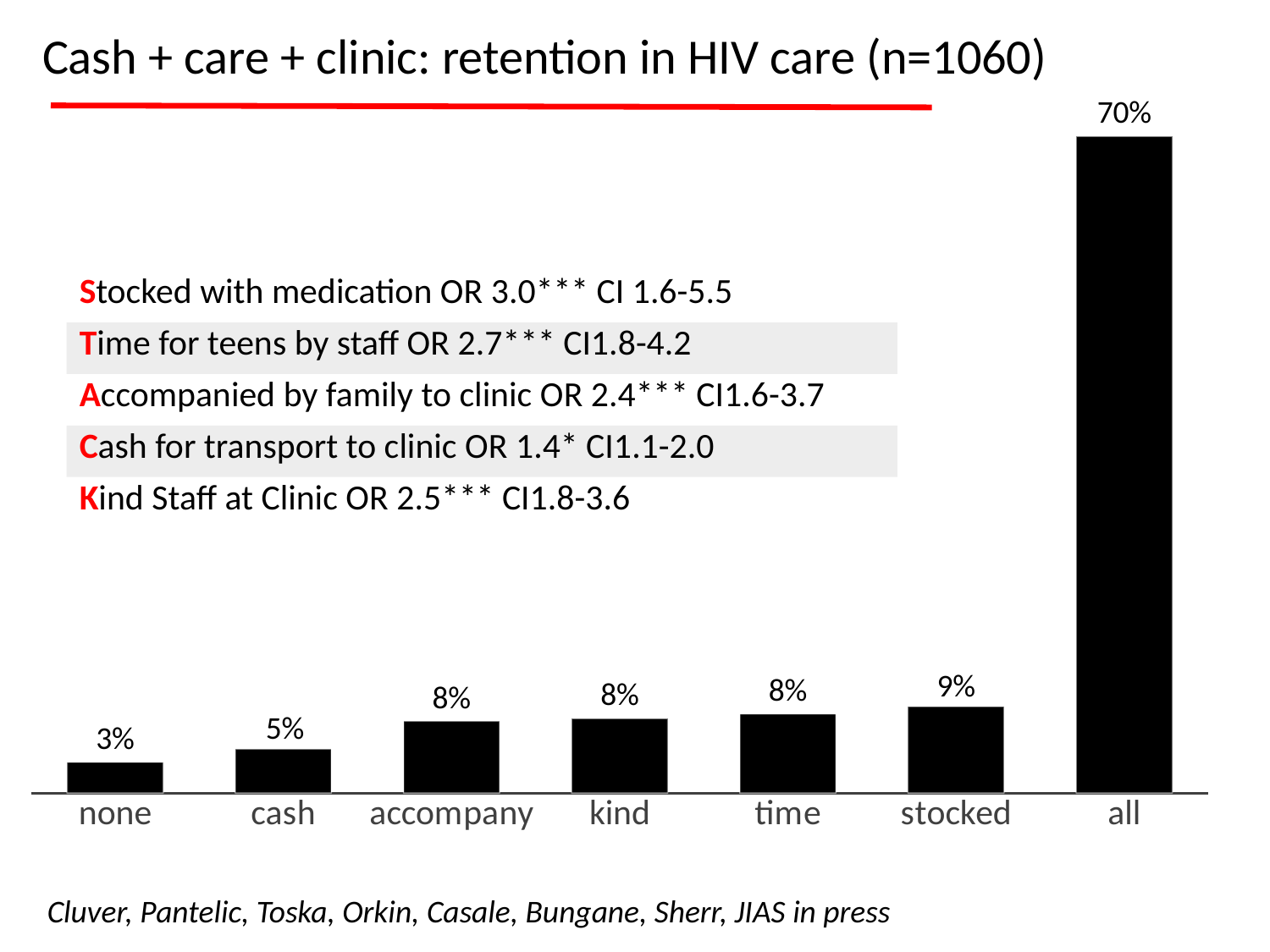
Which is larger, the value for 'stocked' or the value for 'cash'? stocked Which category has the lowest value? none What is the difference between the values for 'all' and 'stocked'? 61% Which category has the highest value? all How many categories are shown on the x axis? 7 What kind of chart is shown on the slide? bar chart What is the value for the 'all' category? 70% What is the value for the 'stocked' category? 9% What is the value for the 'cash' category? 5% What is the difference between the values for 'cash' and 'none'? 2% What is the title of the slide containing the chart? Cash + care + clinic: retention in HIV care (n=1060) What is the value for the 'none' category? 3%